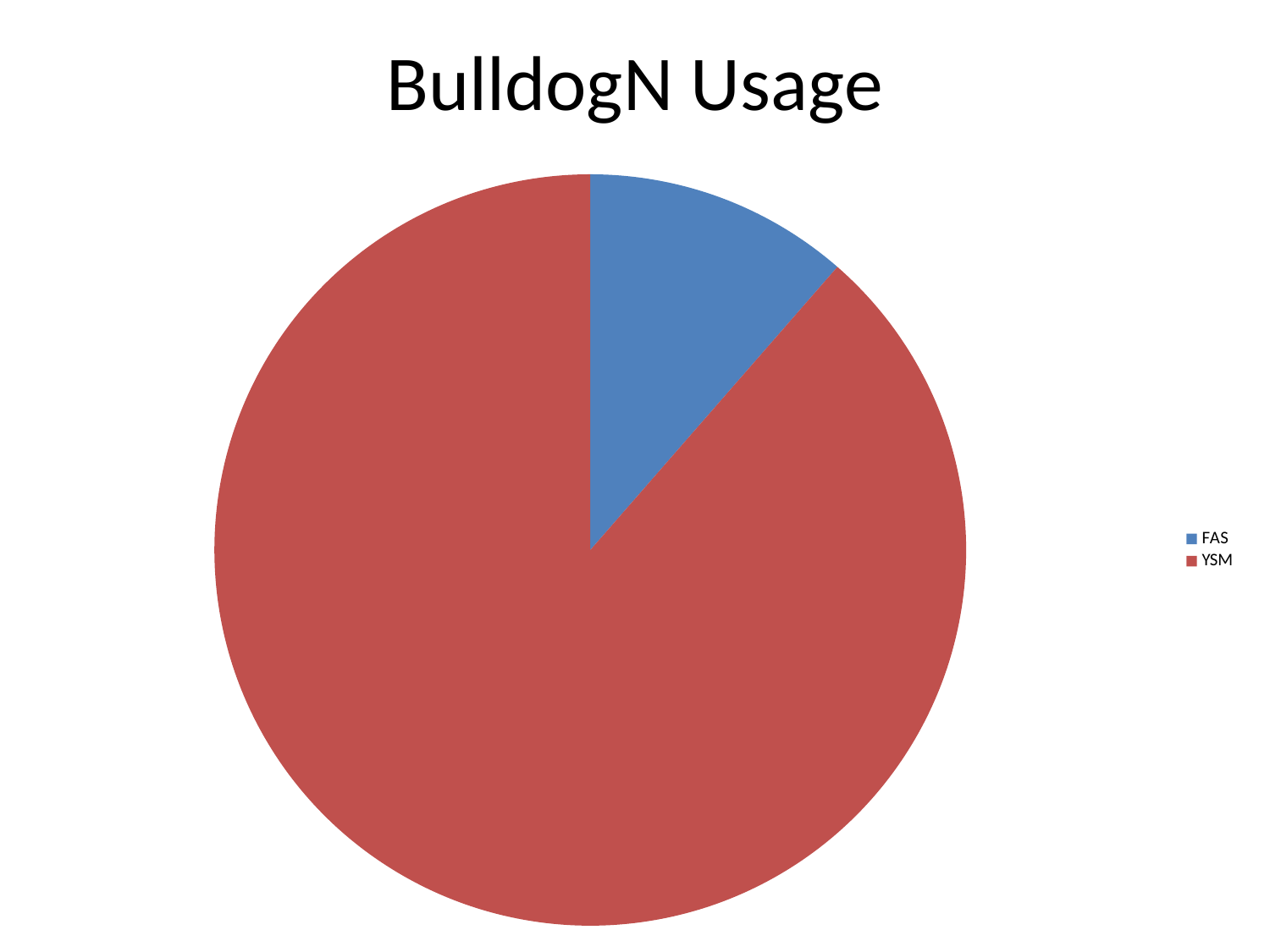
Which colour represents YSM in the chart? red Does the FAS slice take up more or less than a quarter of the pie? less What is the title of the chart? BulldogN Usage What kind of chart is shown on the slide? pie chart Does the YSM slice take up more or less than half of the pie? more How many categories does the legend list? 2 Which category has the largest slice of the pie? YSM Which category has the smallest slice of the pie? FAS Which slice is larger, FAS or YSM? YSM